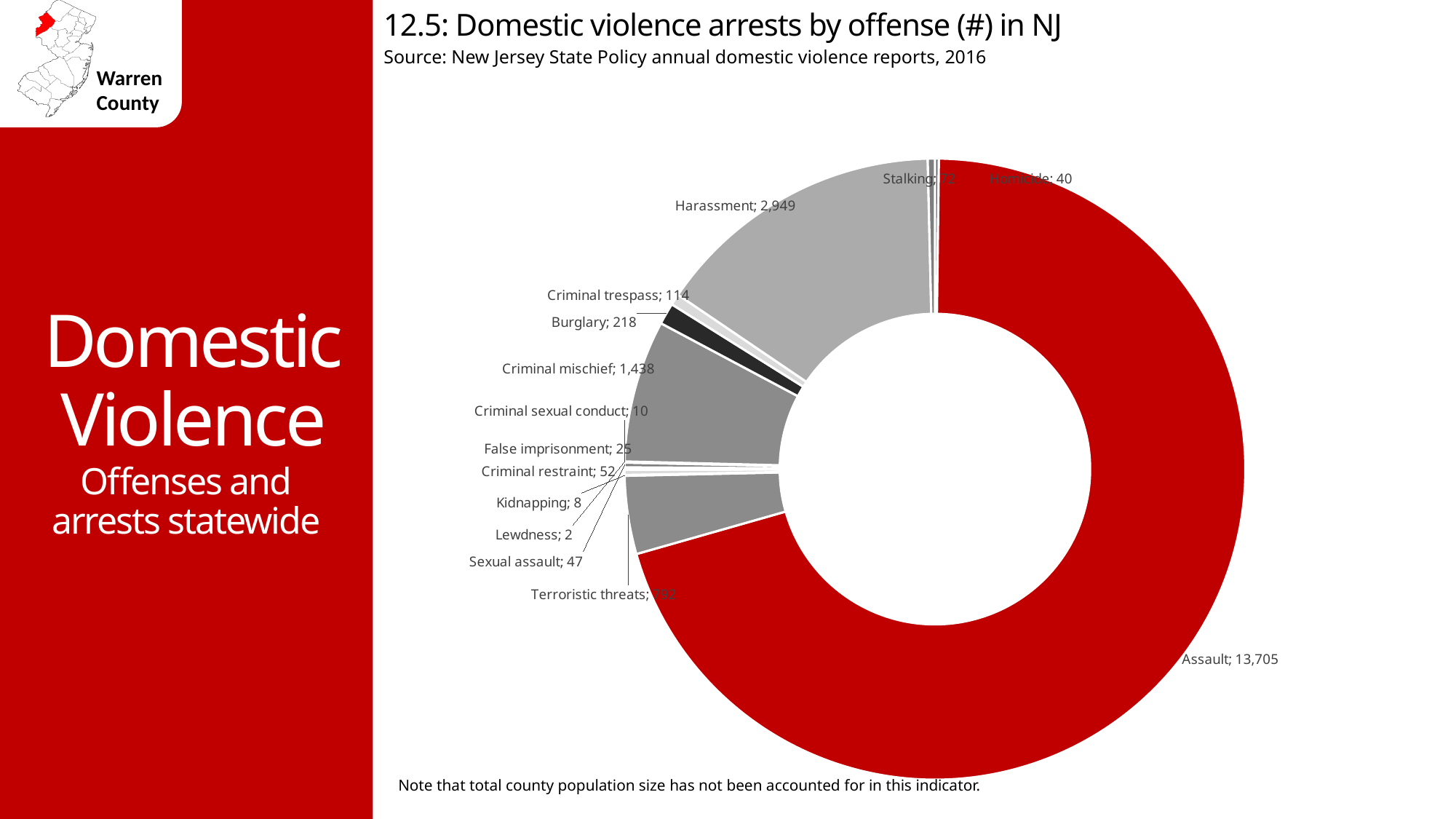
What is the value for Criminal restraint? 52 Which is larger, the value for Burglary or the value for Criminal trespass? Burglary What kind of chart is shown on the slide? Doughnut (pie) chart What is the title of the chart? 12.5: Domestic violence arrests by offense (#) in NJ Which offense has the lowest number of arrests? Lewdness What is the value for Harassment? 2,949 What is the value for Criminal mischief? 1,438 What is the value for Burglary? 218 How many offense categories are shown in the chart? 14 How many domestic violence arrests for Assault are shown? 13,705 Which offense has the highest number of arrests? Assault What is the difference between the Harassment and Criminal mischief values? 1,511